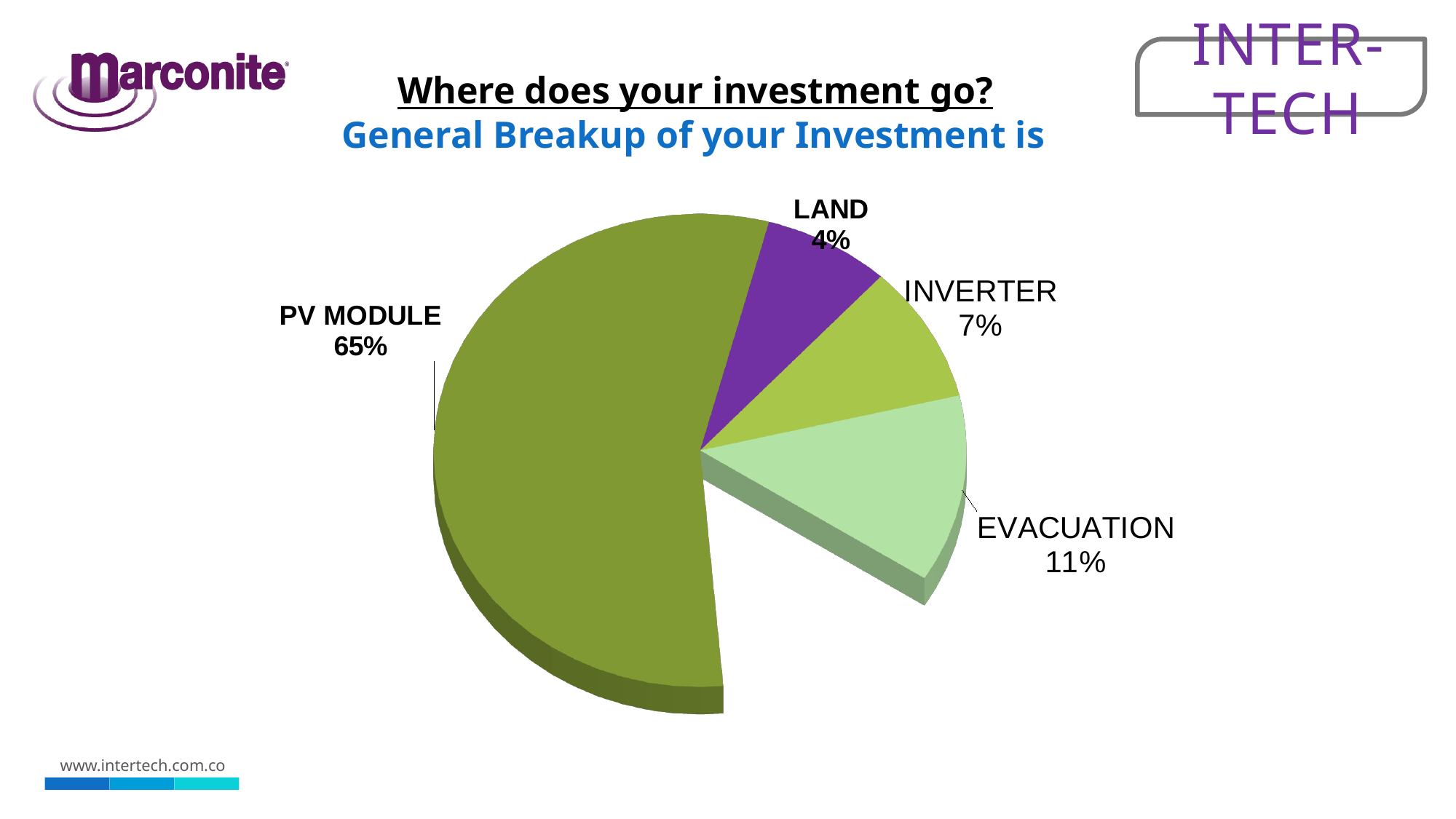
What is the difference in percentage points between the PV MODULE share and the EVACUATION share? 54 What share of the investment goes to INVERTER? 7% Which slice of the pie chart is coloured purple? LAND Which is larger, the share for INVERTER or the share for LAND? INVERTER How many categories are shown in the pie chart? 4 What share of the investment goes to EVACUATION? 11% What share of the investment goes to PV MODULE? 65% What share of the investment goes to LAND? 4% Which category has the largest share of the investment? PV MODULE What is the combined share of INVERTER and LAND? 11% What kind of chart is shown on the slide? pie chart Which category has the smallest share of the investment? LAND